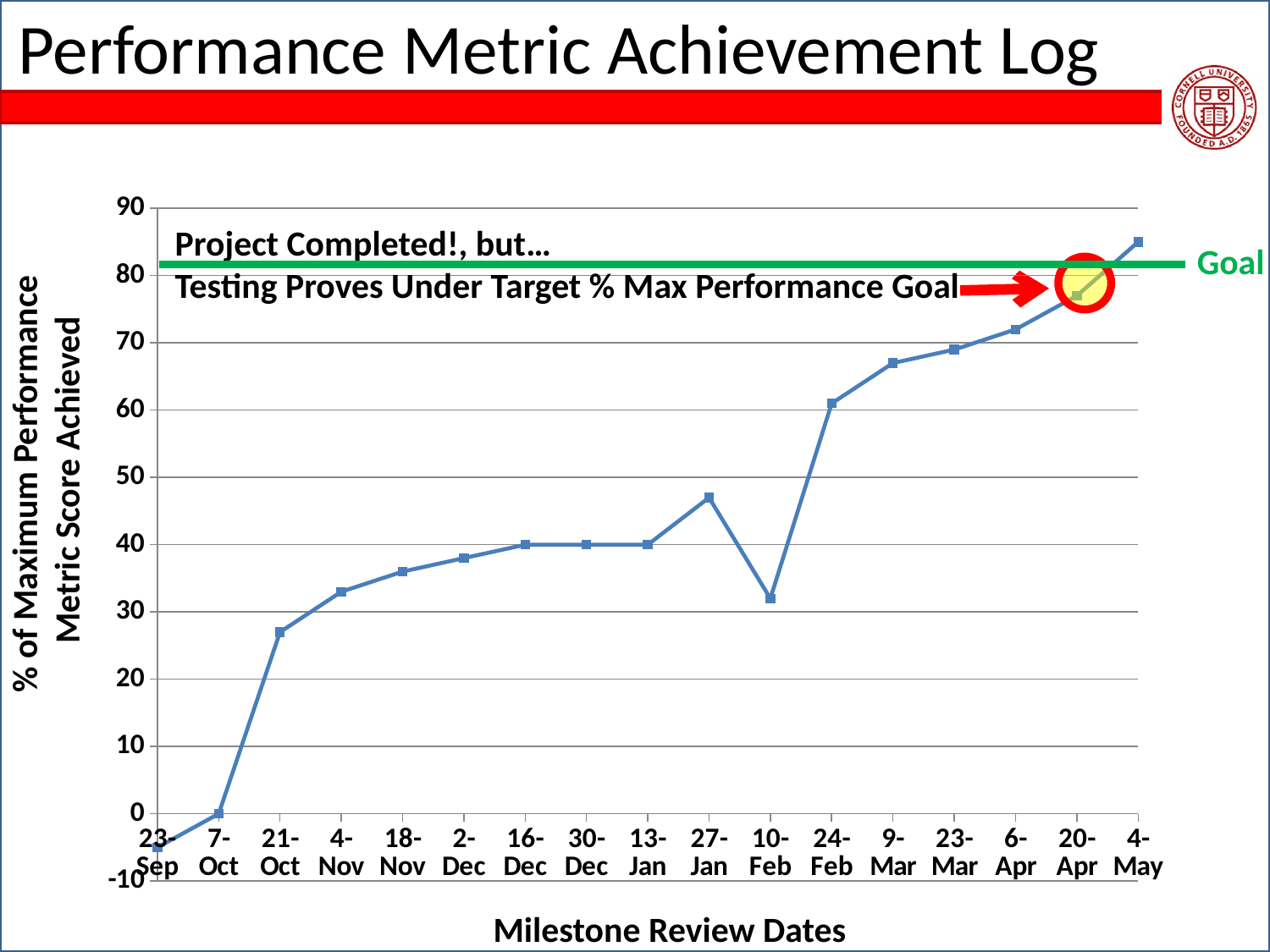
Do the values generally rise or fall from 23-Sep to 4-May? rise How many milestone review dates are plotted on the x axis? 17 Is the value for 9-Mar greater or less than 60? greater Which milestone review date has the lowest value? 23-Sep What is the title of the x axis? Milestone Review Dates What is the value for 7-Oct? 0 Is the value for 21-Oct greater or less than 30? less What is the value for 16-Dec? 40 Which is larger, the value for 27-Jan or the value for 10-Feb? 27-Jan Which milestone review date has the highest value? 4-May What is the value for 13-Jan? 40 What kind of chart is shown on the slide? line chart